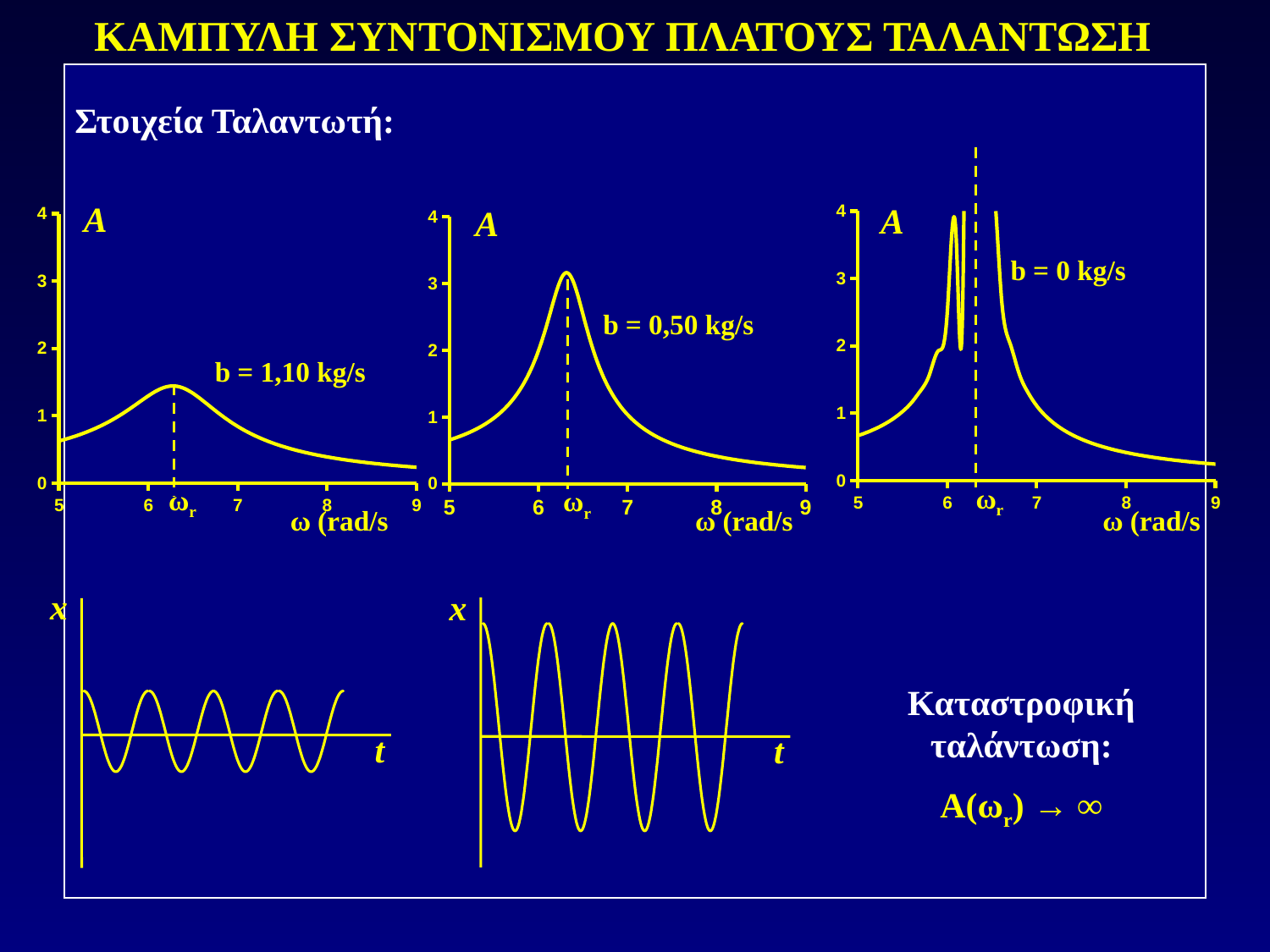
Which resonance curve reaches a higher peak amplitude, b = 1,10 kg/s or b = 0,50 kg/s? b = 0,50 kg/s On the left chart (b = 1,10 kg/s), is the peak value of A greater or less than 2? less On the left chart, does A rise or fall as ω increases from 7 to 9 rad/s? fall What damping value b is labelled on the right-hand resonance curve? b = 0 kg/s How many x versus t oscillation plots are shown at the bottom of the slide? 2 On the middle chart (b = 0,50 kg/s), is the peak value of A greater or less than 2? greater On the left chart (b = 1,10 kg/s), is the value of A at ω = 5 rad/s greater or less than 1? less Which of the three damping values gives the highest peak amplitude A? b = 0 kg/s What is the maximum value shown on the vertical axis of each resonance curve? 4 How many A versus ω resonance curves are shown on the slide? 3 What kind of chart is the left-hand A versus ω plot? line chart What damping value b is labelled on the middle resonance curve? b = 0,50 kg/s